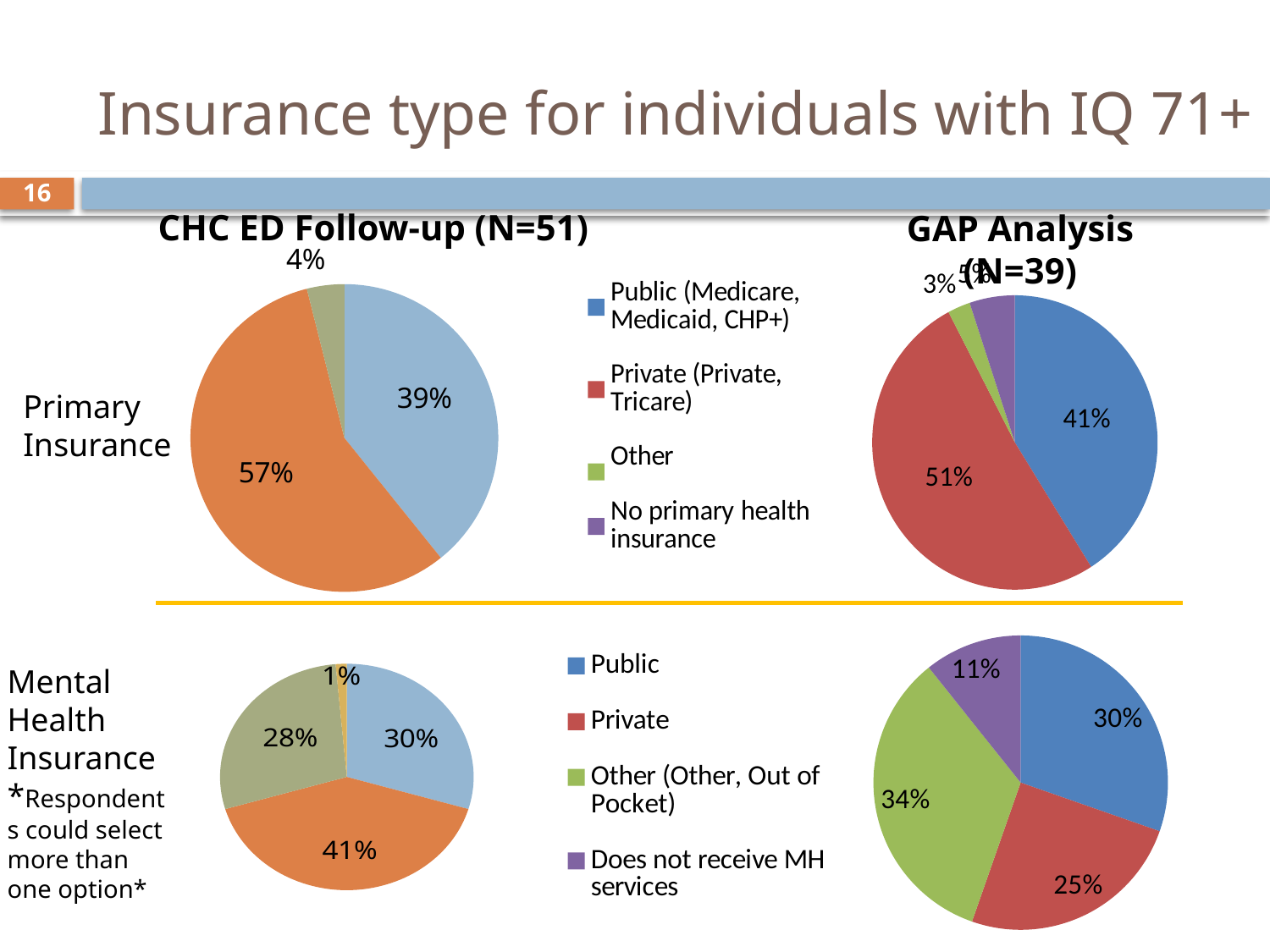
In the GAP Analysis Primary Insurance pie chart (top right), which category has the largest share? Private (Private, Tricare) In the GAP Analysis Mental Health Insurance pie chart (bottom right), what share is Other (Other, Out of Pocket)? 34% In the CHC ED Follow-up Primary Insurance pie chart (top left), what share is Private (Private, Tricare)? 57% In the CHC ED Follow-up Primary Insurance pie chart (top left), what share is Other? 4% In the GAP Analysis Primary Insurance pie chart (top right), what share is Private (Private, Tricare)? 51% In the GAP Analysis Primary Insurance pie chart (top right), what is the difference between the Private and Public shares? 10% In the CHC ED Follow-up Primary Insurance pie chart (top left), what share is Public (Medicare, Medicaid, CHP+)? 39% In the CHC ED Follow-up Mental Health Insurance pie chart (bottom left), which category has the smallest share? Does not receive MH services What type of chart is used for the Primary Insurance data on this slide? Pie chart In the GAP Analysis Mental Health Insurance pie chart (bottom right), which is larger, Public or Private? Public In the GAP Analysis Mental Health Insurance pie chart (bottom right), what share is Does not receive MH services? 11% In the CHC ED Follow-up Mental Health Insurance pie chart (bottom left), what share is Private? 41%